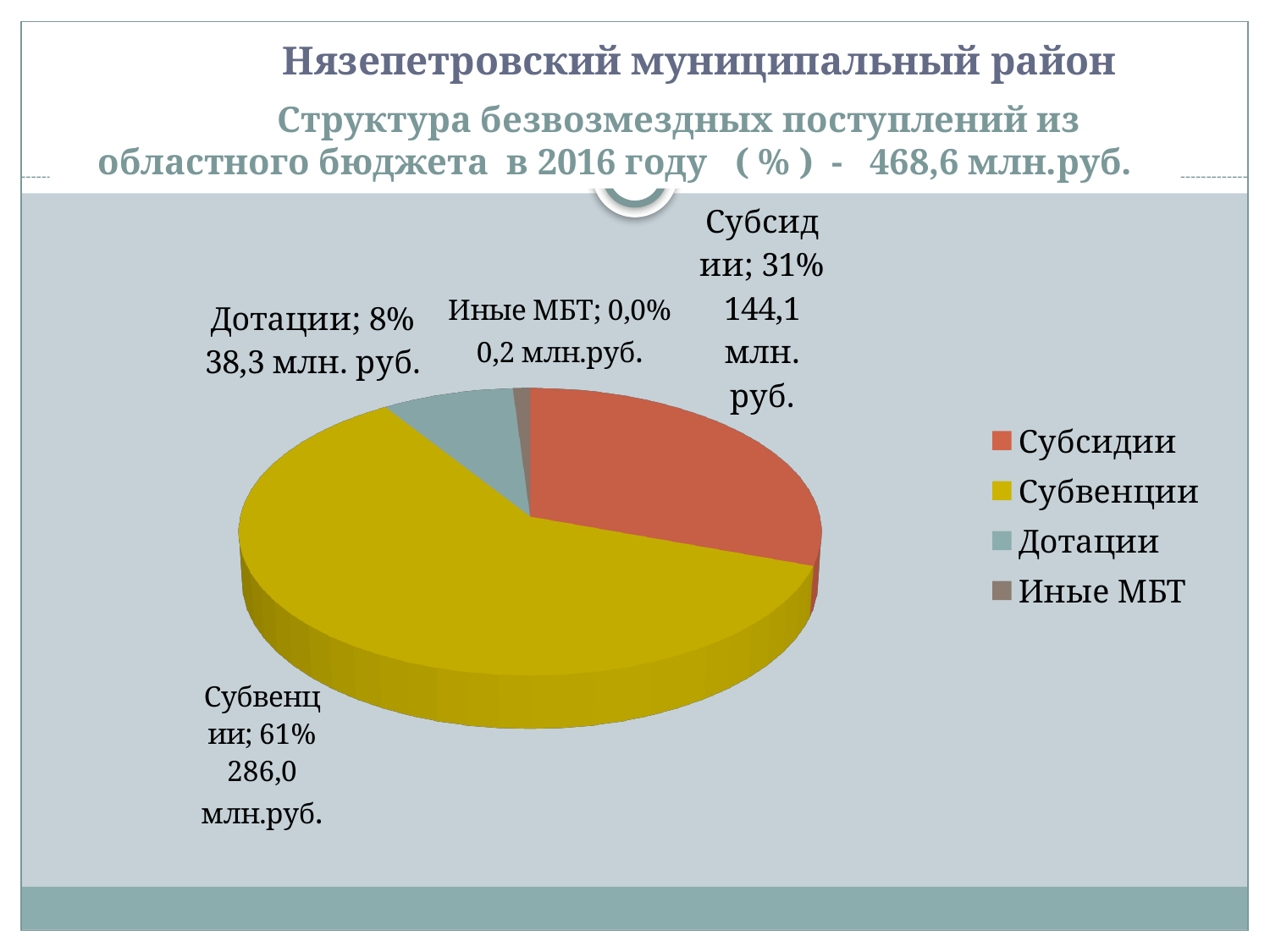
What is the value in млн.руб. shown for Субвенции? 286,0 млн.руб. What share of the pie does Субвенции take? 61% What is the value in млн.руб. shown for Иные МБТ? 0,2 млн.руб. Which is larger, the share for Субсидии or the share for Дотации? Субсидии What share of the pie does Субсидии take? 31% How many categories does the legend list? 4 Which category has the smallest slice of the pie? Иные МБТ What share of the pie does Дотации take? 8% What is the value in млн.руб. shown for Субсидии? 144,1 млн. руб. Which category has the largest slice of the pie? Субвенции What kind of chart is shown on the slide? Pie chart What colour is the Субвенции slice? Yellow